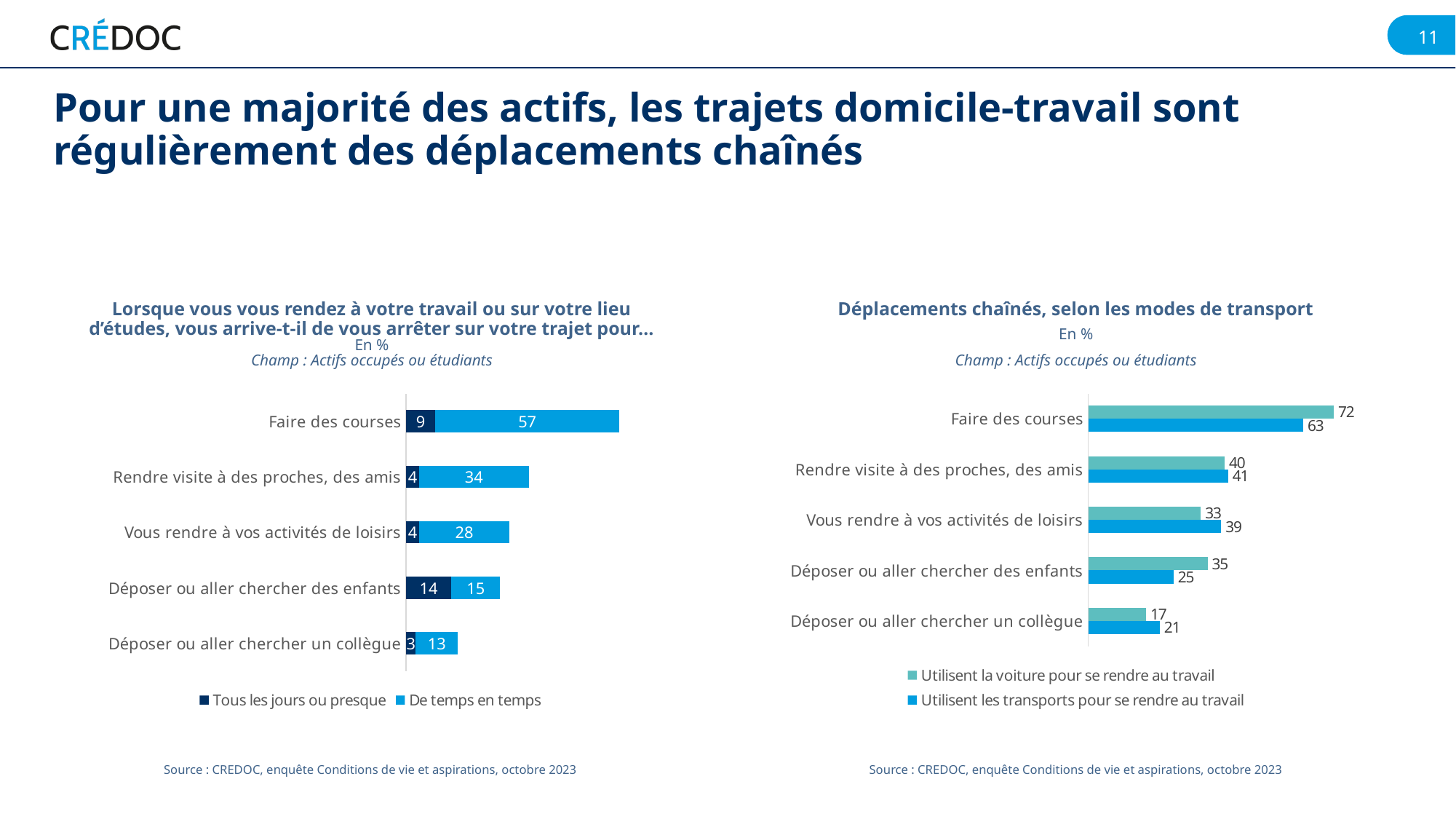
In the left chart, what is the 'De temps en temps' value for 'Faire des courses'? 57 In the left chart, which category has the lowest 'De temps en temps' value? Déposer ou aller chercher un collègue What kind of chart is the right chart 'Déplacements chaînés, selon les modes de transport'? Bar chart In the right chart 'Déplacements chaînés, selon les modes de transport', for 'Vous rendre à vos activités de loisirs', which is larger: the car value or the public transport value? Public transport (39) In the right chart 'Déplacements chaînés, selon les modes de transport', what is the difference between the car and public transport values for 'Déposer ou aller chercher des enfants'? 10 In the left chart, which category has the highest 'Tous les jours ou presque' value? Déposer ou aller chercher des enfants In the left chart, what is the 'Tous les jours ou presque' value for 'Déposer ou aller chercher des enfants'? 14 In the left chart, what is the total of the stacked bar for 'Faire des courses'? 66 In the right chart 'Déplacements chaînés, selon les modes de transport', what is the value for 'Faire des courses' among those who use the car to get to work? 72 In the left chart, how many series does the legend list? 2 In the right chart 'Déplacements chaînés, selon les modes de transport', how many categories are shown? 5 In the right chart 'Déplacements chaînés, selon les modes de transport', what is the value for 'Déposer ou aller chercher un collègue' among those who use public transport? 21